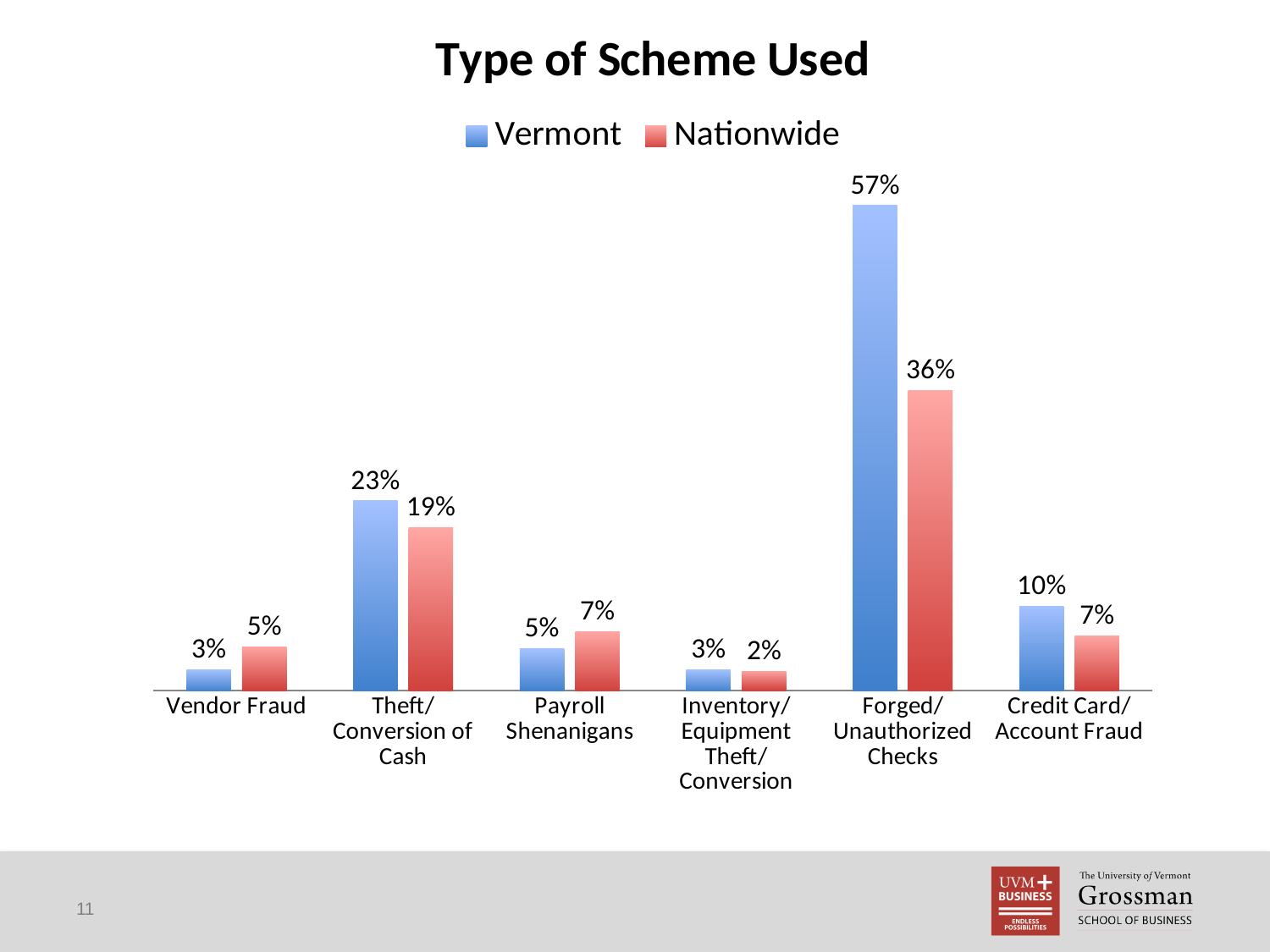
Which category has the lowest Nationwide value? Inventory/Equipment Theft/Conversion Which category has the highest Vermont value? Forged/Unauthorized Checks What is the Nationwide value for Theft/Conversion of Cash? 19% What is the Nationwide value for Vendor Fraud? 5% What kind of chart is shown on the slide? Bar chart How many categories are shown on the x axis? 6 What is the Vermont value for Forged/Unauthorized Checks? 57% What is the Vermont value for Credit Card/Account Fraud? 10% How many series does the legend list? 2 What is the difference between the Vermont and Nationwide values for Forged/Unauthorized Checks? 21% What is the title of the chart? Type of Scheme Used Which is larger for Payroll Shenanigans, the Vermont value or the Nationwide value? Nationwide